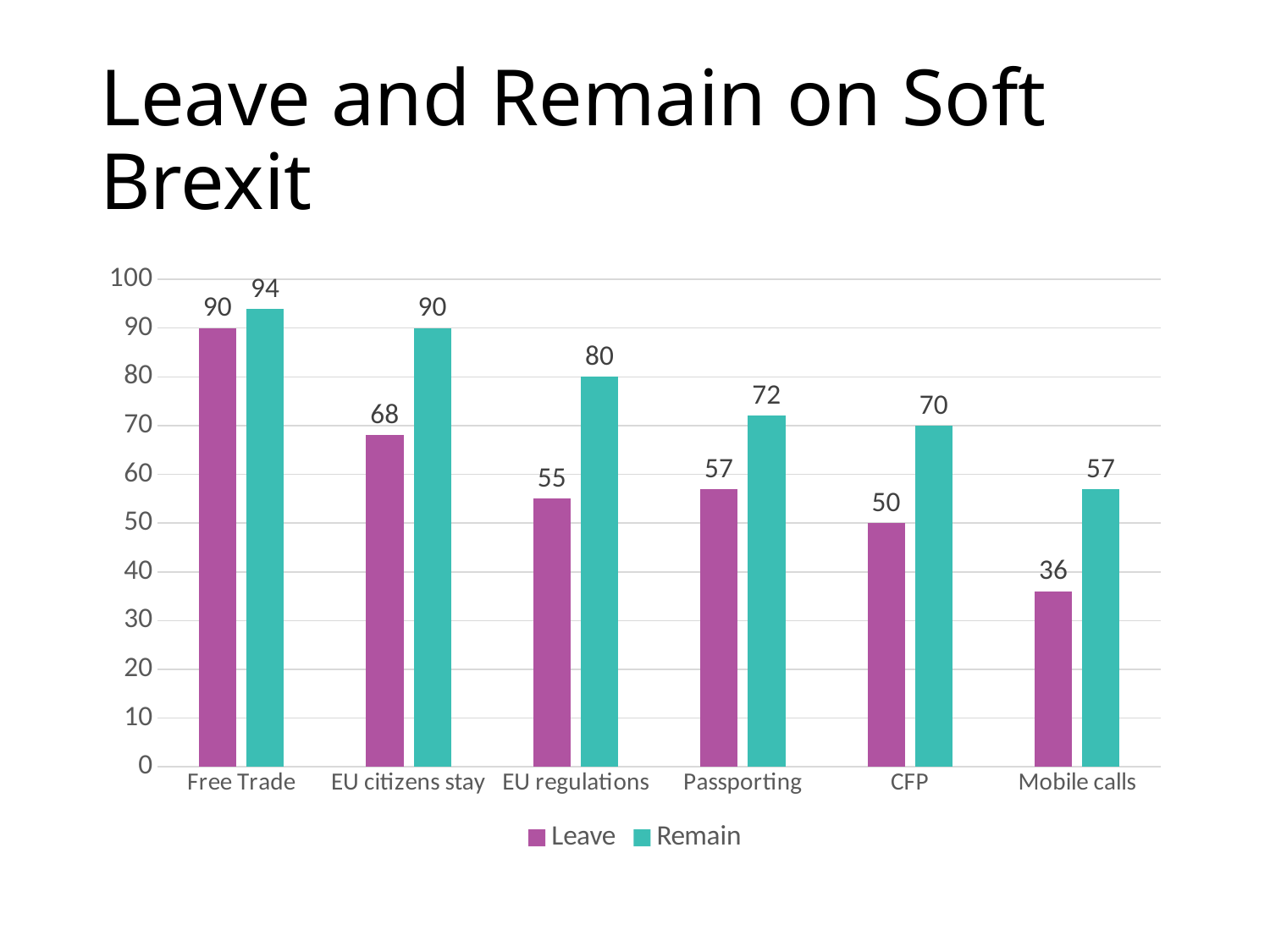
Which category has the lowest Leave value? Mobile calls How many categories are shown on the x axis? 6 Which category has the highest Remain value? Free Trade What is the Remain value for EU regulations? 80 What is the Leave value for Free Trade? 90 What is the difference between the Remain and Leave values for EU citizens stay? 22 Which is larger for CFP, the Leave value or the Remain value? Remain What kind of chart is shown on the slide? bar chart How many series does the legend list? 2 What is the Leave value for Mobile calls? 36 Do the Remain values rise or fall from Free Trade to Mobile calls? fall What is the title of the slide? Leave and Remain on Soft Brexit